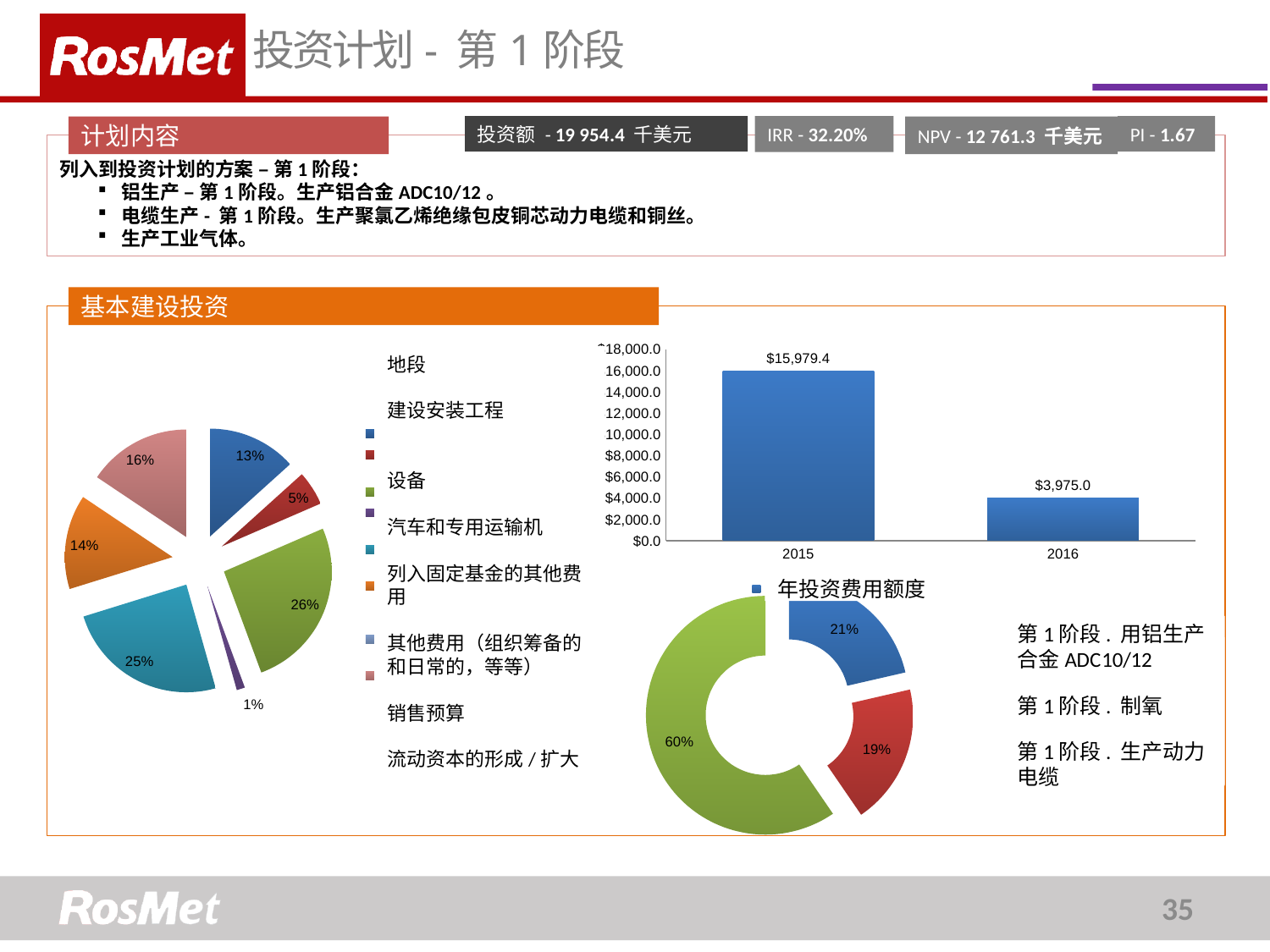
In the bar chart titled 年投资费用额度, what is the value for 2016? $3,975.0 In the bar chart titled 年投资费用额度, what is the value for 2015? $15,979.4 In the exploded pie chart on the left of the slide, how many slices are there? 7 In the exploded pie chart on the left of the slide, what is the percentage of the smallest slice? 1% In the exploded pie chart on the left of the slide, what is the percentage of the largest slice? 26% In the bar chart titled 年投资费用额度, what is the difference between the 2015 and 2016 values? $12,004.4 In the bar chart titled 年投资费用额度, which year has the higher value? 2015 In the bar chart titled 年投资费用额度, do the values rise or fall from 2015 to 2016? fall What kind of chart is the chart titled 年投资费用额度? bar chart In the donut chart at the bottom right of the slide, what is the percentage of the largest segment? 60% In the bar chart titled 年投资费用额度, what is the total of the two bars? $19,954.4 In the bar chart titled 年投资费用额度, how many bars are plotted? 2